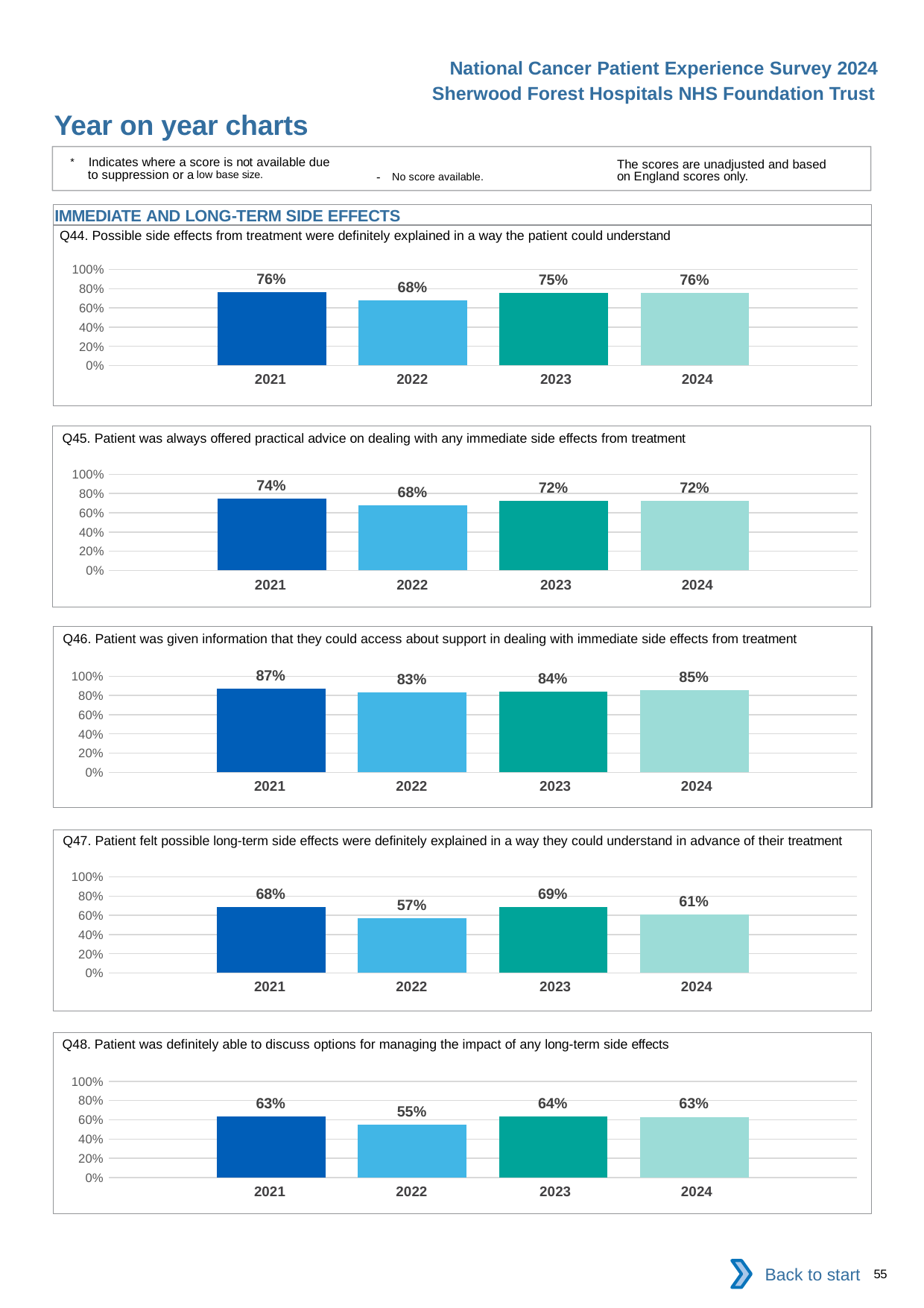
In the Q45 chart, is the value for 2022 greater or less than 60%? greater In the Q47 chart, which year has the lowest value? 2022 In the Q46 chart, what is the difference between the 2021 and 2022 values? 4% In the Q48 chart, what is the difference between the 2023 and 2022 values? 9% In the Q48 chart, what is the value for 2024? 63% In the Q47 chart, is the value for 2023 larger or smaller than the value for 2024? larger In the Q46 chart, what is the value for 2024? 85% What kind of chart is the Q45 chart? bar chart What is the section heading above the Q44 chart? IMMEDIATE AND LONG-TERM SIDE EFFECTS How many years are shown in the Q44 chart? 4 In the Q44 chart, what is the value for 2022? 68% In the Q45 chart, which year has the highest value? 2021